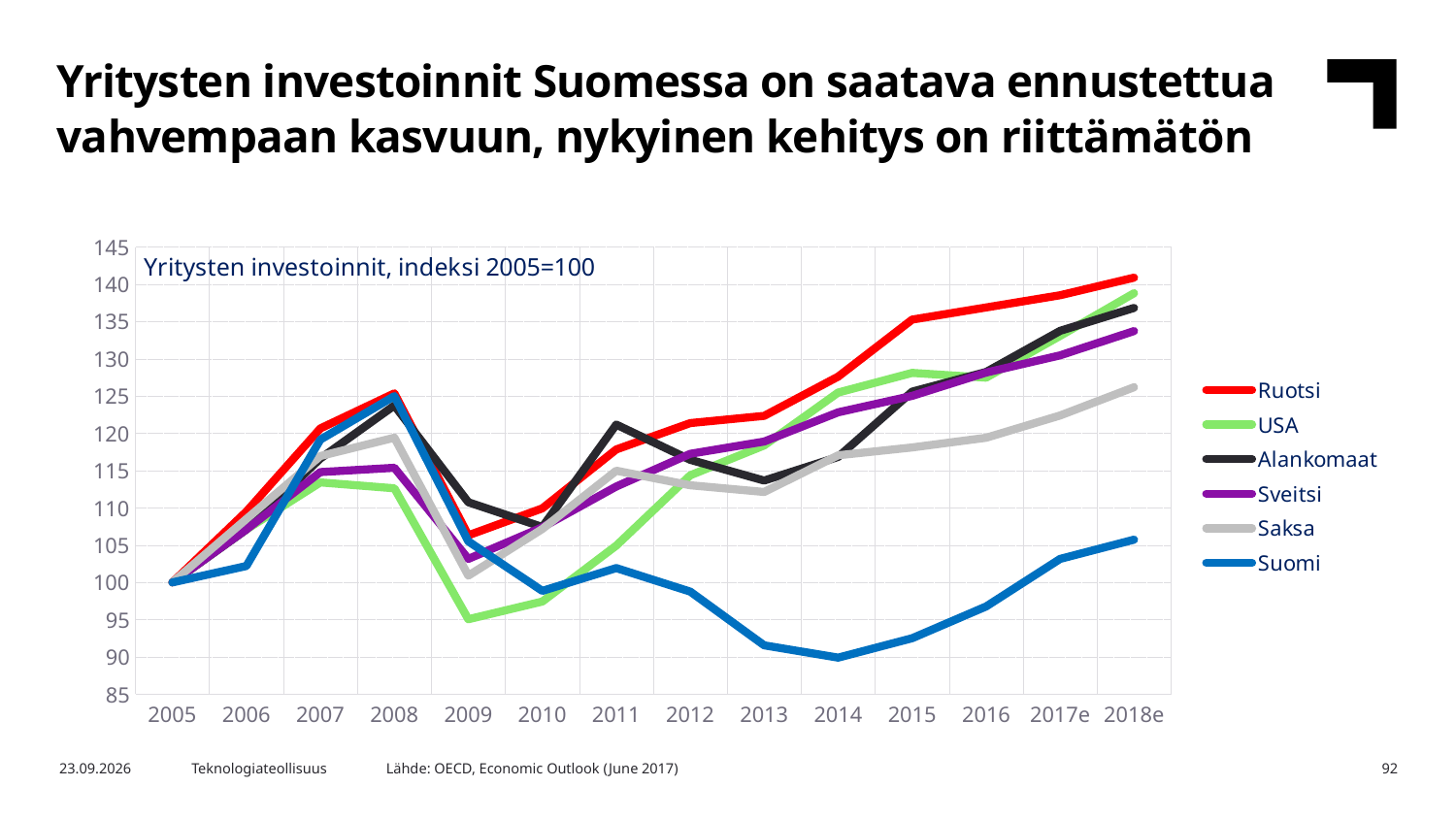
Which country has the highest value in 2011? Alankomaat Is the value for Ruotsi in 2018e greater or less than 135? greater Does the value for Suomi rise or fall from 2011 to 2014? fall Which country has the lowest value in 2018e? Suomi How many series does the legend list? 6 How many years (points) are shown along the x axis? 14 Is the value for USA in 2009 greater or less than 100? less Is the value for Suomi in 2014 greater or less than 95? less Which is larger in 2016, the value for Ruotsi or the value for Suomi? Ruotsi What kind of chart is shown on the slide? line chart What is the index value for all countries in 2005? 100 What is the title printed inside the chart area? Yritysten investoinnit, indeksi 2005=100